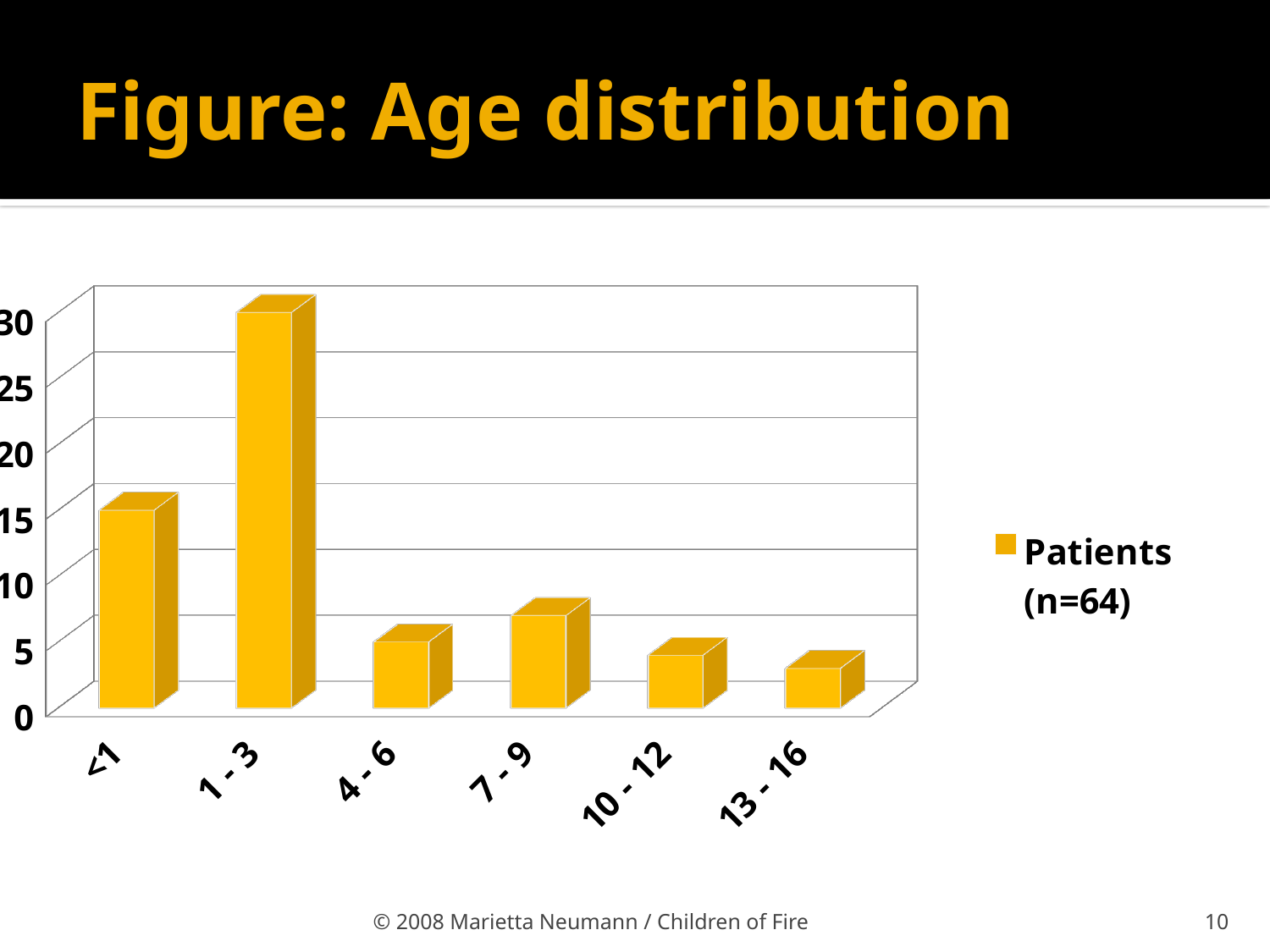
How many series does the legend list? 1 Which age group has more patients, <1 or 1 - 3? 1 - 3 Which age group has the highest number of patients? 1 - 3 How many age categories are shown on the x axis? 6 Which age group has the lowest number of patients? 13 - 16 What is the title of the slide? Figure: Age distribution Is the value for the 4 - 6 age group greater or less than 10? less Which age group has more patients, 7 - 9 or 13 - 16? 7 - 9 Is the value for the 1 - 3 age group greater or less than 25? greater Is the value for the <1 age group greater or less than 10? greater What is the legend entry for the series? Patients (n=64) What kind of chart is shown on the slide? bar chart